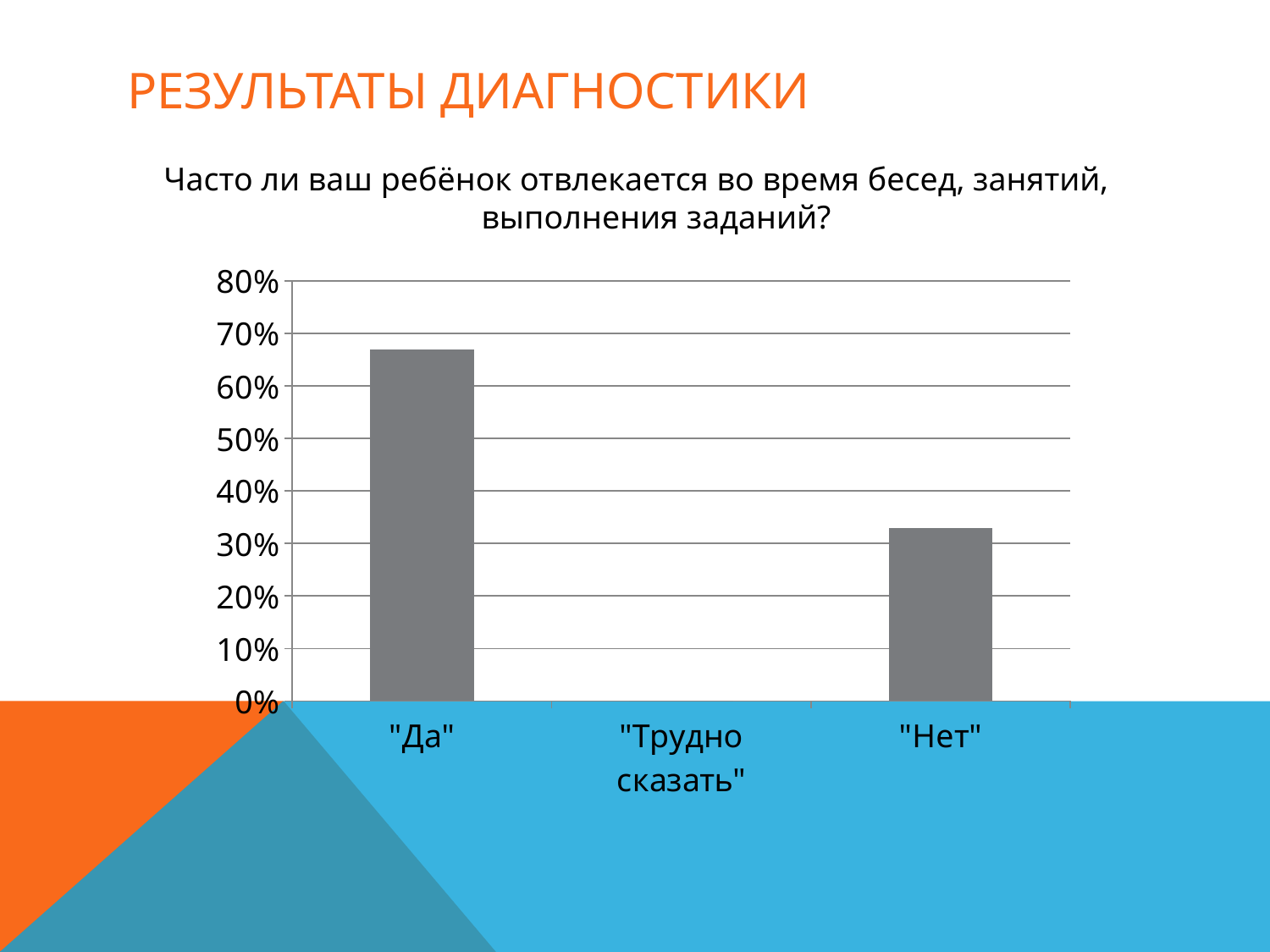
How many categories are shown on the x axis of the chart? 3 What kind of chart is shown on the slide? bar chart Which category has the highest value? "Да" Is the value for "Да" greater or less than 60%? greater Is the value for "Нет" greater or less than 30%? greater Which category has the lowest value? "Трудно сказать" What is the title of the chart? Часто ли ваш ребёнок отвлекается во время бесед, занятий, выполнения заданий? What is the highest value shown on the y axis of the chart? 80% Is the value for "Нет" greater or less than 40%? less Which is larger, the value for "Да" or the value for "Нет"? "Да"